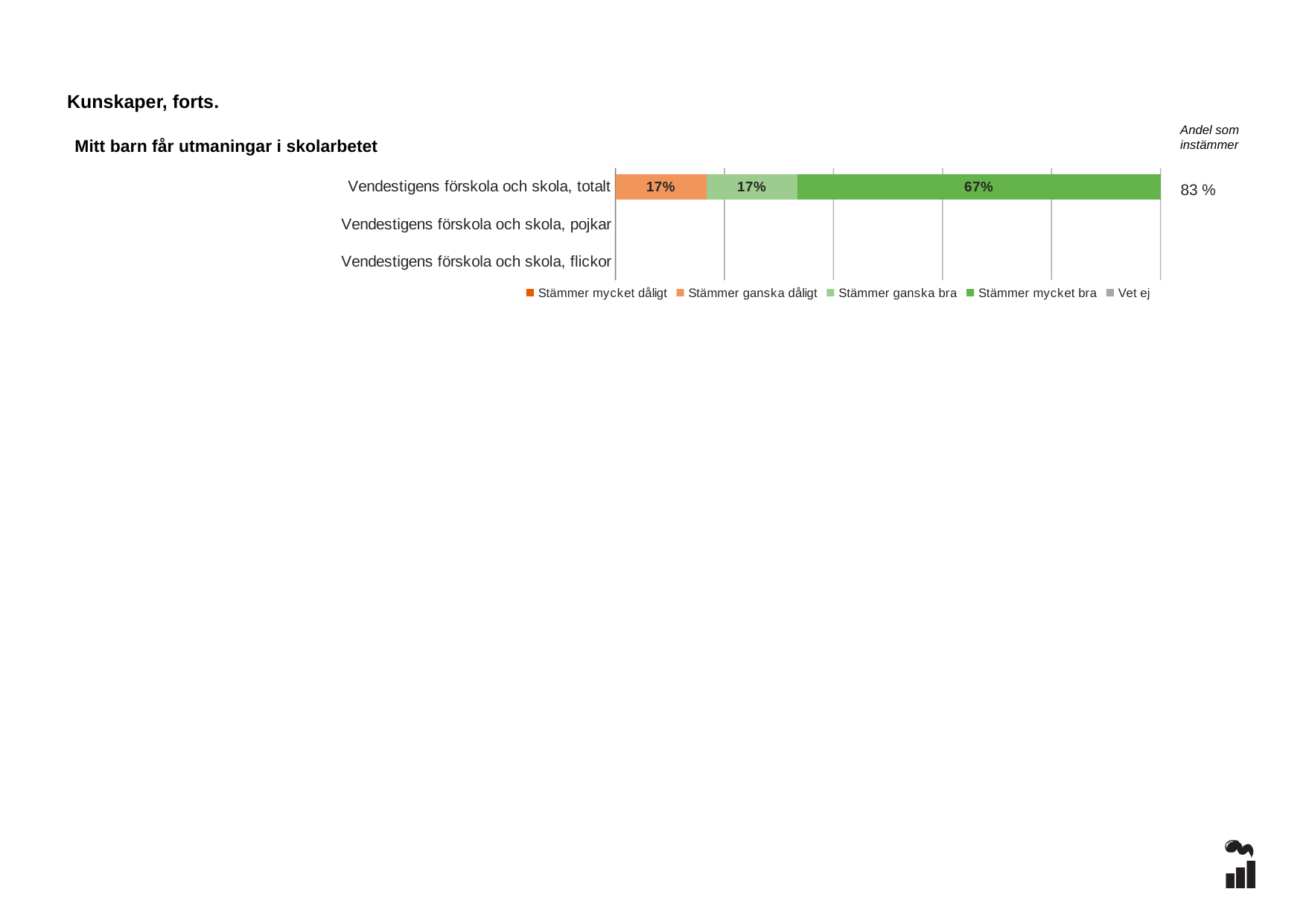
What is the value for "Stämmer ganska bra" for Vendestigens förskola och skola, totalt? 17% What is the value for "Stämmer ganska dåligt" for Vendestigens förskola och skola, totalt? 17% How many series does the legend list? 5 How many category rows are listed on the y axis of the chart? 3 What is the "Andel som instämmer" value shown for Vendestigens förskola och skola, totalt? 83 % Which is larger for Vendestigens förskola och skola, totalt: the "Stämmer mycket bra" share or the "Stämmer ganska dåligt" share? Stämmer mycket bra Which legend entry is shown in grey? Vet ej What is the difference between the "Stämmer mycket bra" share and the "Stämmer ganska bra" share for Vendestigens förskola och skola, totalt? 50% What kind of chart is shown on the slide? Stacked bar chart What is the title of the chart? Mitt barn får utmaningar i skolarbetet What is the value for "Stämmer mycket bra" for Vendestigens förskola och skola, totalt? 67% Which response category has the largest share in the bar for Vendestigens förskola och skola, totalt? Stämmer mycket bra